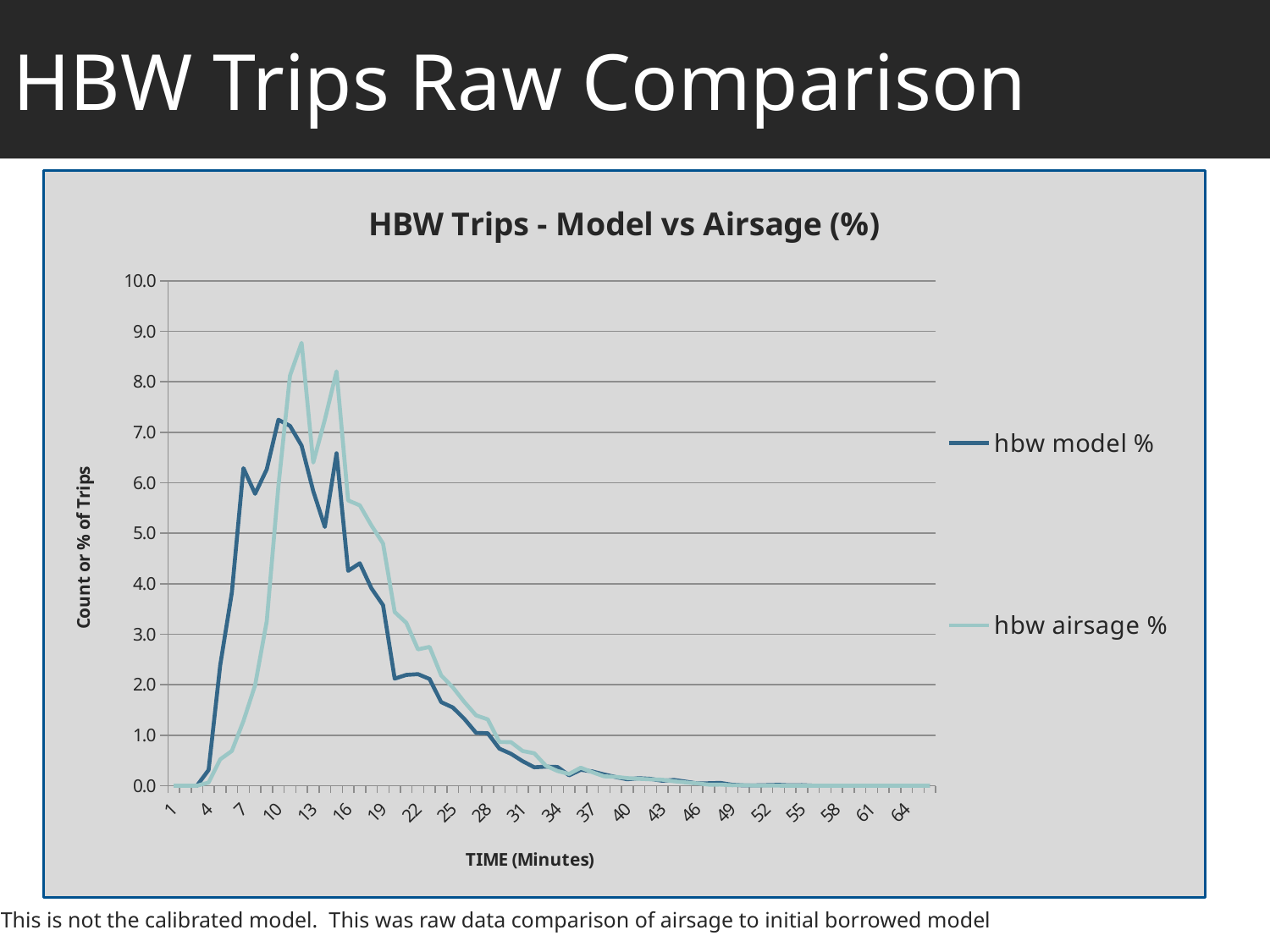
Which series reaches the higher peak value, hbw model % or hbw airsage %? hbw airsage % How many series does the legend list? 2 Which series rises to its first peak earlier along the time axis, hbw model % or hbw airsage %? hbw model % What is the title of the chart? HBW Trips - Model vs Airsage (%) Is the value of the hbw model % series at time 1 greater or less than 1.0? less What is the label of the x axis? TIME (Minutes) What kind of chart is shown on the slide? line chart Is the value of the hbw airsage % series at time 40 greater or less than 1.0? less Is the peak value of the hbw airsage % series greater or less than 8.0? greater Do the values of both series rise or fall along the x axis after about 20 minutes? fall